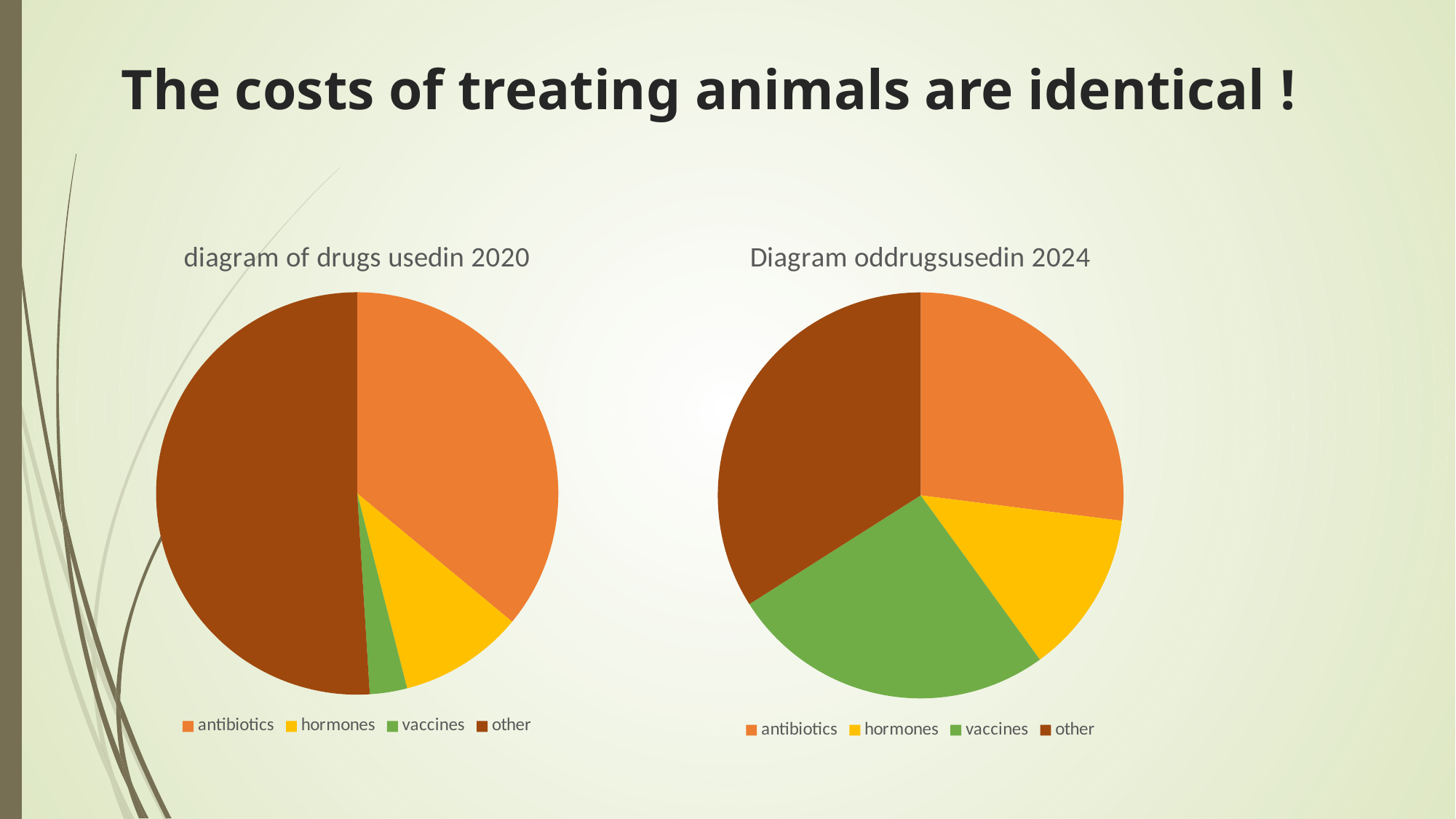
In the left chart (2020), which category has the largest slice? other In the right chart (2024), which category has the largest slice? other In the right chart (2024), how many entries does the legend list? 4 In the right chart (2024), which category has the smallest slice? hormones In the left chart (2020), how many slices does the pie have? 4 In the left chart (2020), which slice is larger, antibiotics or hormones? antibiotics In the right chart (2024), what colour is the 'vaccines' slice? green In the left chart (2020), which slice is larger, hormones or vaccines? hormones In the left chart (2020), which category has the smallest slice? vaccines What kind of chart is the left chart, 'diagram of drugs usedin 2020'? pie chart What kind of chart is the right chart, 'Diagram oddrugsusedin 2024'? pie chart In the right chart (2024), which slice is larger, vaccines or hormones? vaccines